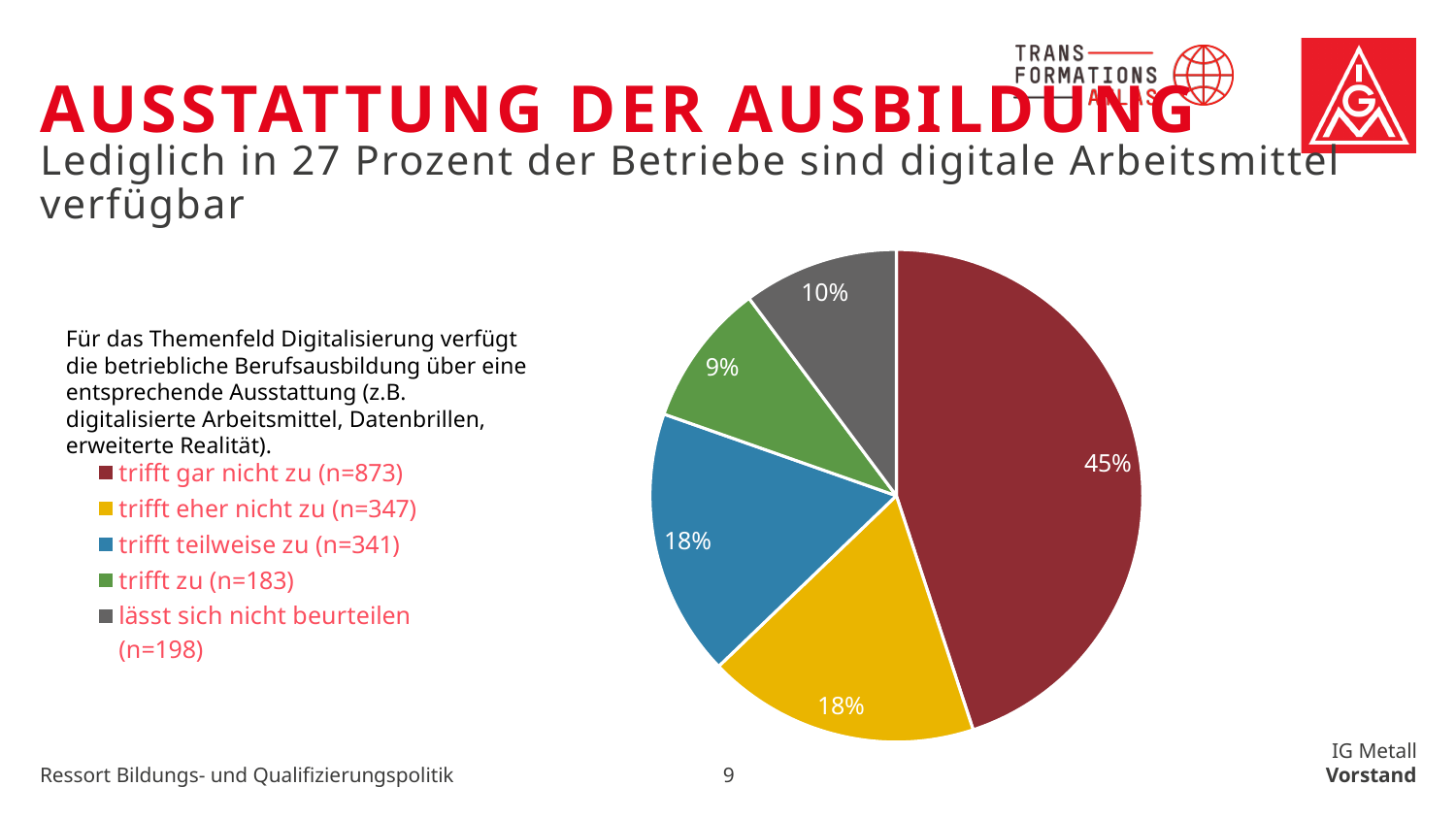
What percentage is shown for "trifft zu (n=183)"? 9% What percentage is shown for "lässt sich nicht beurteilen (n=198)"? 10% Which is larger, the slice for "trifft zu" or the slice for "lässt sich nicht beurteilen"? lässt sich nicht beurteilen What share of the pie does "trifft gar nicht zu (n=873)" have? 45% Which category has the smallest slice of the pie? trifft zu (n=183) What colour is the slice for "trifft teilweise zu (n=341)"? blue What percentage is shown for "trifft teilweise zu (n=341)"? 18% How many categories does the legend list? 5 What is the difference in percentage points between "trifft gar nicht zu" and "trifft eher nicht zu"? 27 What is the combined share of "trifft eher nicht zu" and "trifft teilweise zu"? 36% What type of chart is shown on the slide? pie chart Which category has the largest slice of the pie? trifft gar nicht zu (n=873)